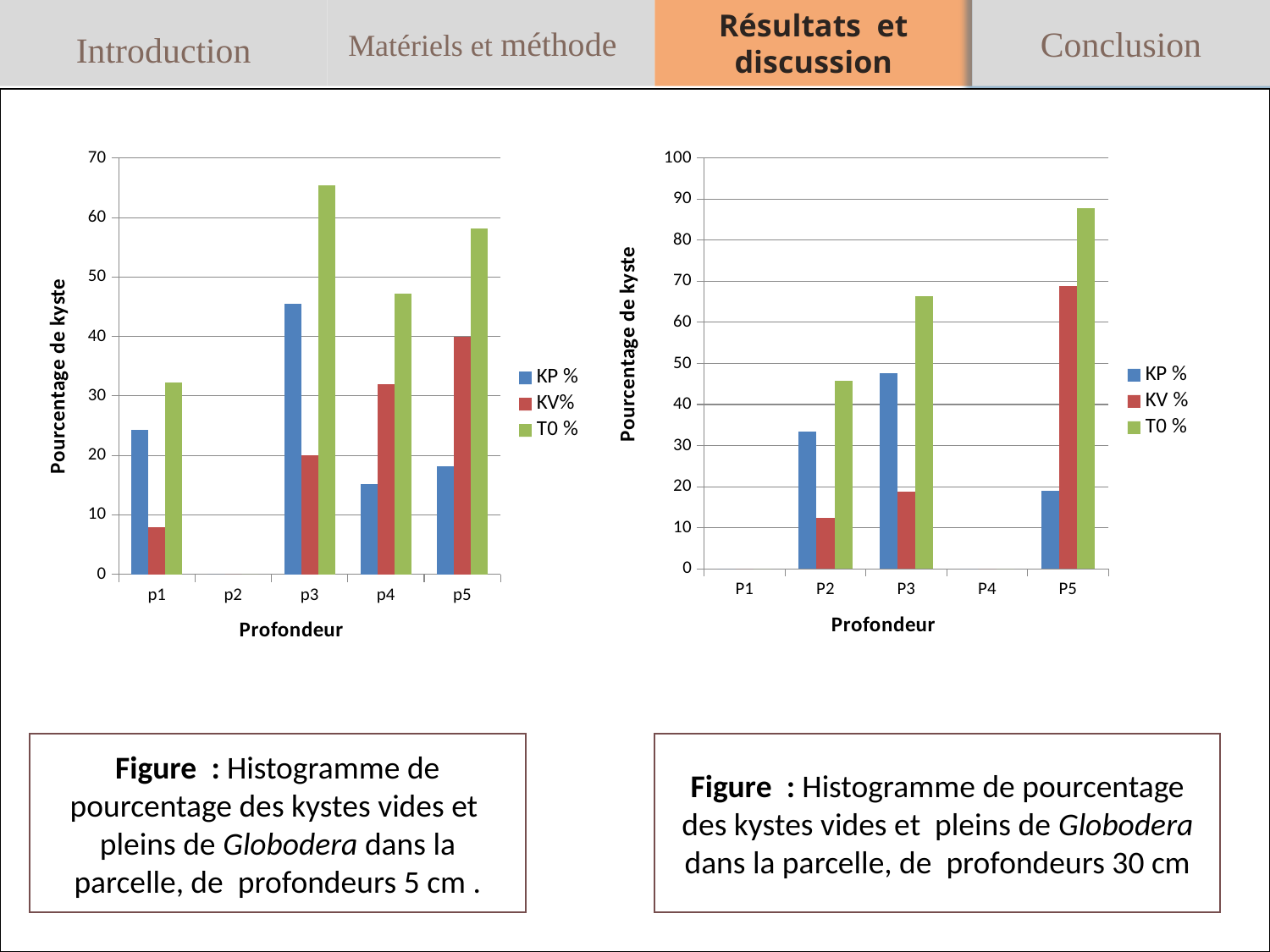
What kind of chart is the left chart (profondeurs 5 cm)? bar chart What is the y-axis title of the right chart (profondeurs 30 cm)? Pourcentage de kyste In the left chart (profondeurs 5 cm), is the T0 % value for p3 greater or less than 60? greater In the left chart (profondeurs 5 cm), which category has the highest T0 % value? p3 In the right chart (profondeurs 30 cm), which is larger for P3: KP % or KV %? KP % In the left chart (profondeurs 5 cm), which is larger for p4: KP % or KV%? KV% In the right chart (profondeurs 30 cm), is the KV % value for P2 greater or less than 20? less How many categories are shown on the x axis of the left chart (profondeurs 5 cm)? 5 How many series does the legend of the right chart (profondeurs 30 cm) list? 3 In the right chart (profondeurs 30 cm), is the KV % value for P5 greater or less than 60? greater In the right chart (profondeurs 30 cm), which category has the highest T0 % value? P5 In the left chart (profondeurs 5 cm), which category has the lowest KV% value among those with bars? p1